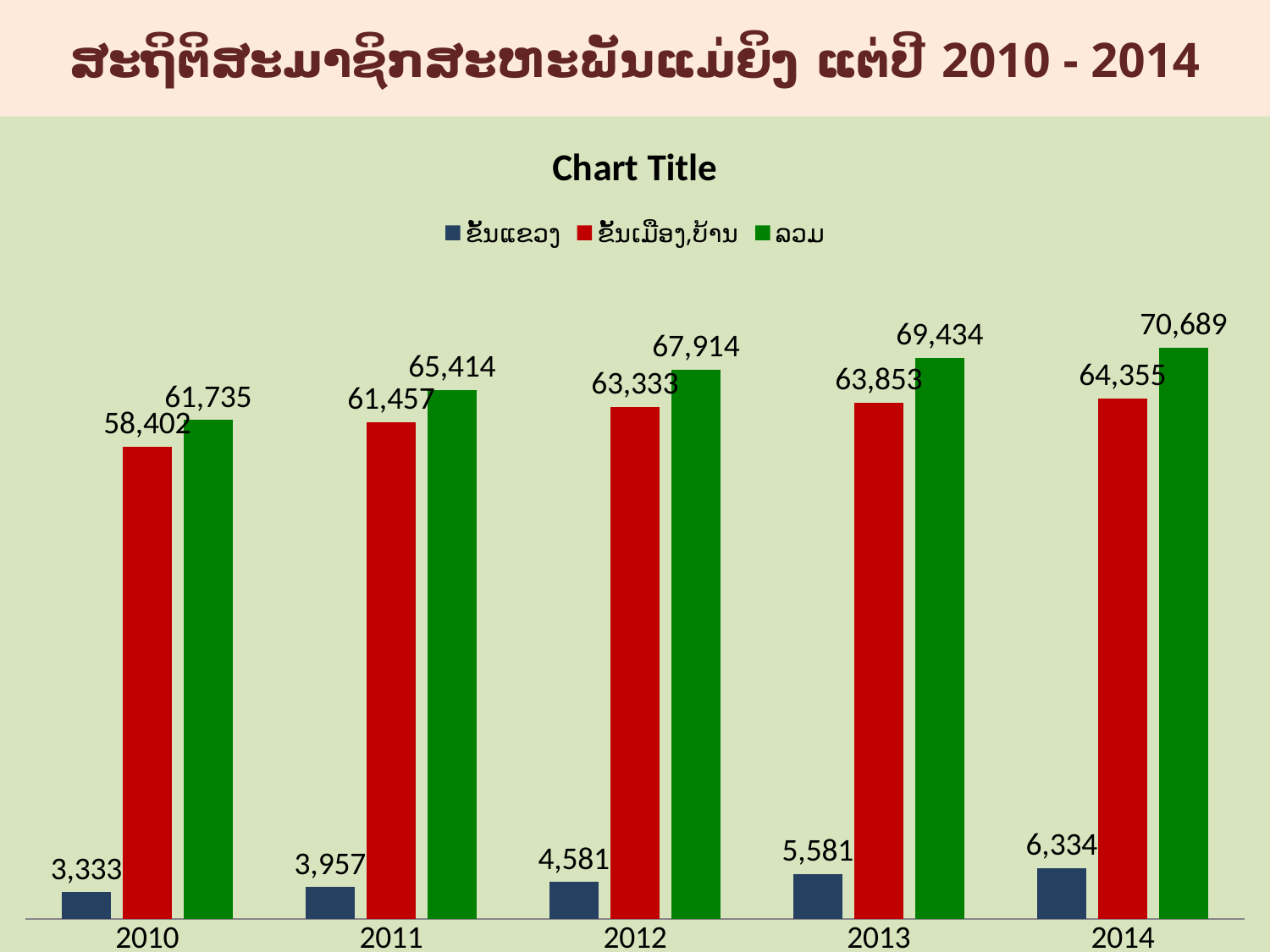
How many series does the legend list? 3 In which year is the green ລວມ series highest? 2014 How many years are shown on the x axis? 5 Does the blue ຂັ້ນແຂວງ series rise or fall from 2010 to 2014? rise What is the title printed above the chart? Chart Title What type of chart is shown on the slide? bar chart What is the difference between the green ລວມ value in 2014 and in 2010? 8,954 What is the value of the green ລວມ series in 2014? 70,689 Which is larger in 2013: the red ຂັ້ນເມືອງ,ບ້ານ value or the green ລວມ value? ລວມ (green) In which year is the blue ຂັ້ນແຂວງ series lowest? 2010 What is the value of the red ຂັ້ນເມືອງ,ບ້ານ series in 2012? 63,333 What is the value of the blue ຂັ້ນແຂວງ series in 2010? 3,333